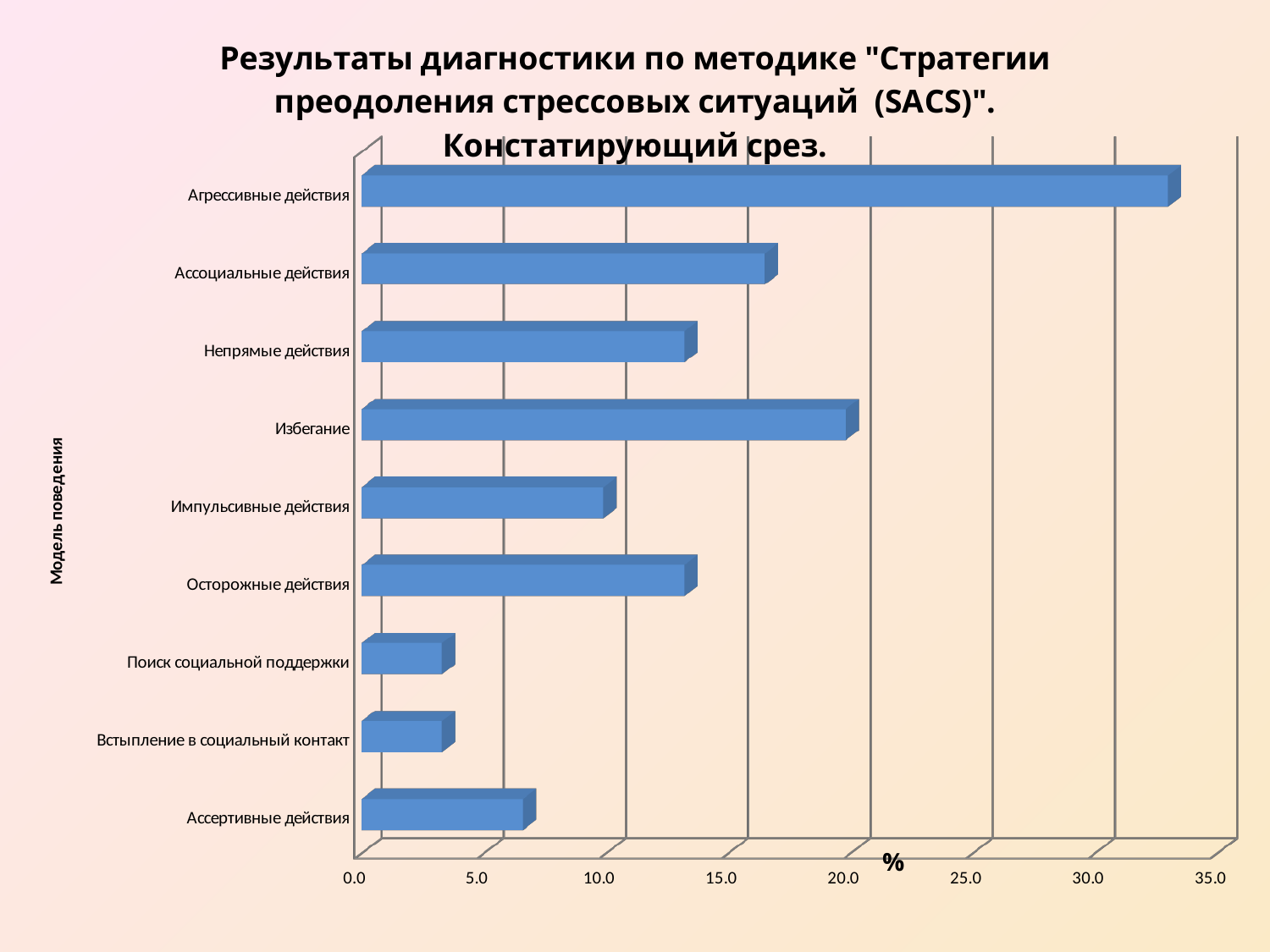
What kind of chart is shown on the slide? bar chart Which behaviour model has the highest value on the chart? Агрессивные действия How many behaviour models (categories) are plotted on the chart? 9 Is the value for Избегание greater or less than 15.0? greater What is the label on the vertical axis of the chart? Модель поведения Which is larger, the value for Ассертивные действия or the value for Поиск социальной поддержки? Ассертивные действия Is the value for Осторожные действия greater or less than 15.0? less Is the value for Избегание greater or less than 25.0? less Which is larger, the value for Избегание or the value for Ассоциальные действия? Избегание